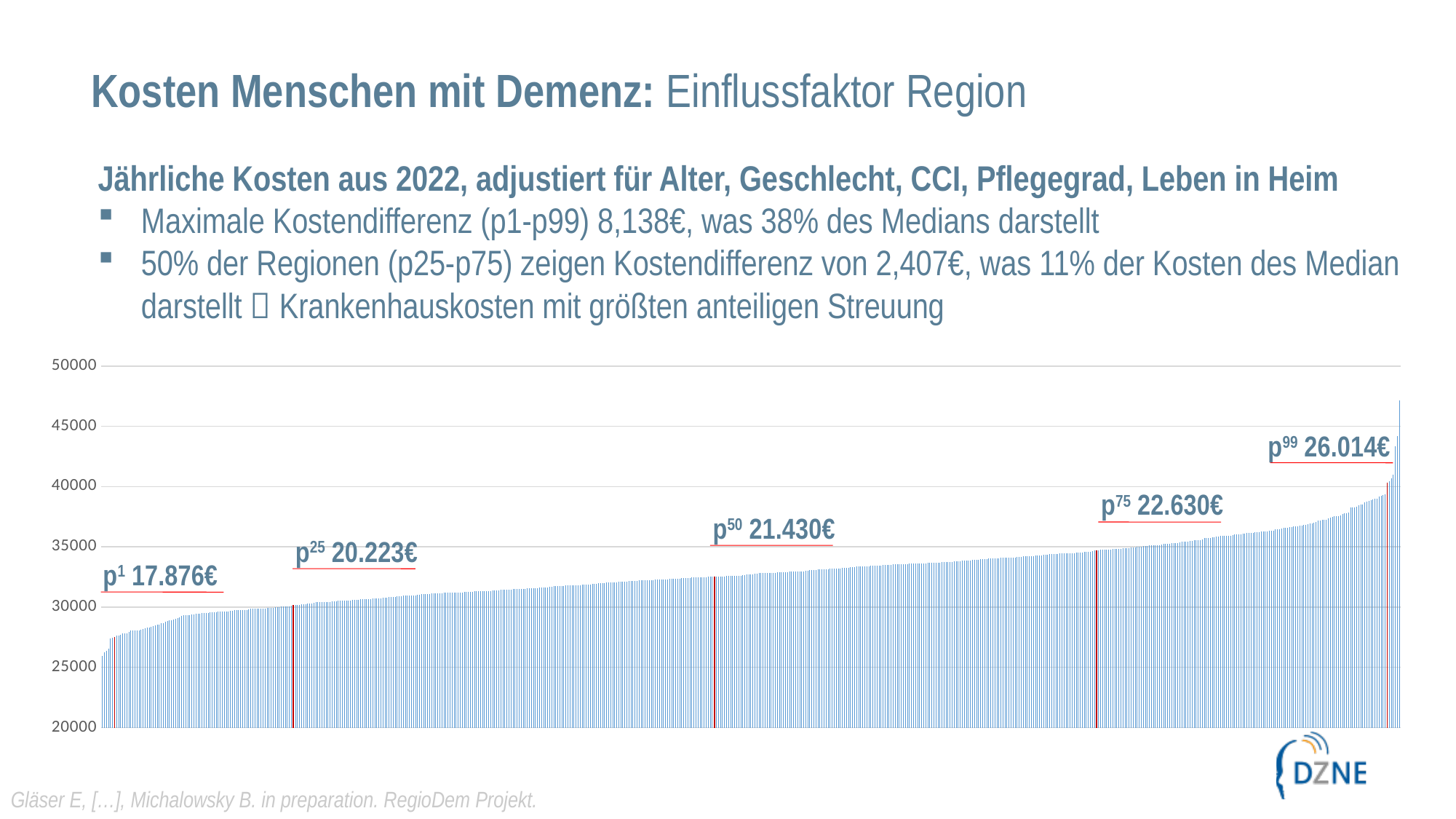
What is the difference between the labelled p99 value and the labelled p1 value? 8.138€ What value is labelled for p99 on the chart? 26.014€ What value is labelled for p75 on the chart? 22.630€ What is the difference between the labelled p75 value and the labelled p25 value? 2.407€ What value is labelled for p1 on the chart? 17.876€ Which labelled percentile value is larger, p50 or p75? p75 What value is labelled for p50 on the chart? 21.430€ Is the value of the shortest bar at the left end of the chart greater or less than 30000? less Is the value of the tallest bar at the right end of the chart greater or less than 45000? greater What value is labelled for p25 on the chart? 20.223€ Do the bar values rise or fall from left to right along the x axis? rise What kind of chart is shown on the slide? bar chart